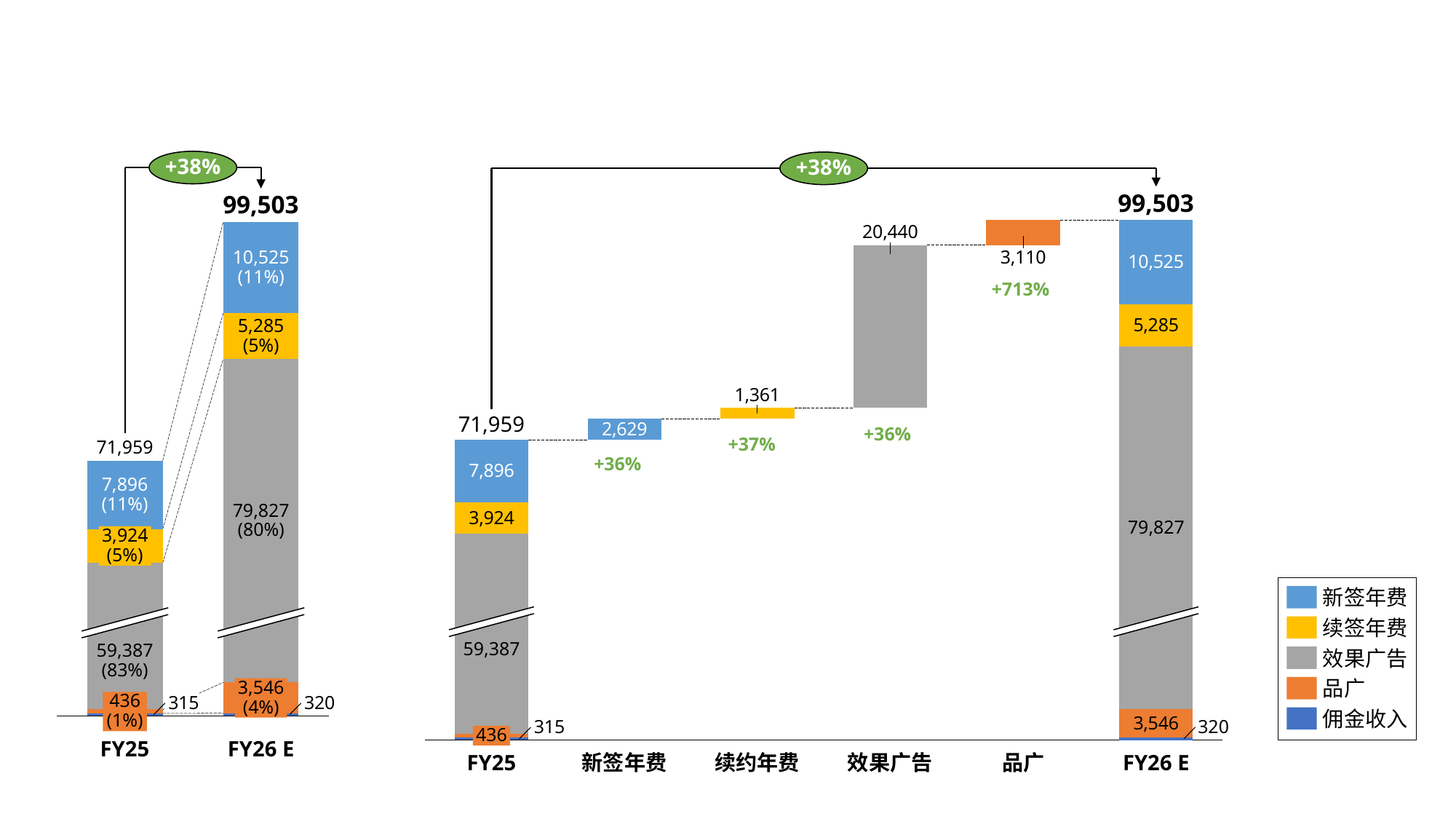
In the left chart, which segment of the FY25 bar is the largest? 效果广告 What overall growth percentage is shown in the green oval above each chart? +38% In the right chart, what is the value of the 效果广告 step? 20,440 In the left chart, what is the total value of the FY26 E bar? 99,503 In the left chart, what share of the FY26 E total does 效果广告 represent? 80% In the left chart, what is the value of 效果广告 for FY25? 59,387 In the right chart, which of the four intermediate steps (新签年费, 续约年费, 效果广告, 品广) is the smallest? 续约年费 In the left chart, what is the difference between the FY26 E total and the FY25 total? 27,544 What kind of chart is the chart on the right? waterfall chart How many series does the legend list? 5 In the right chart, what percentage growth is shown for 品广? +713% In the right chart, is the 新签年费 step (2,629) larger or smaller than the 品广 step (3,110)? smaller